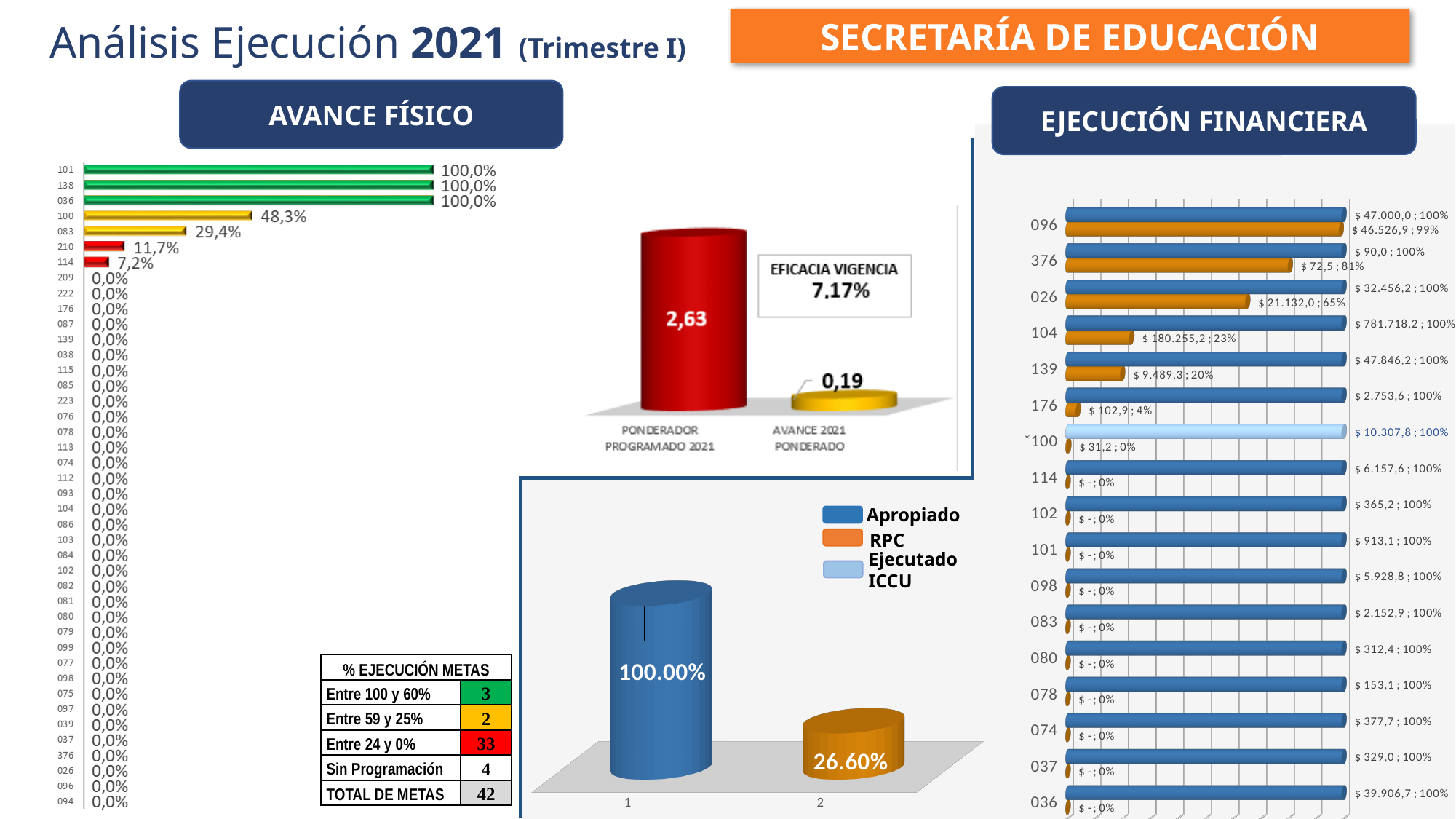
In the Eficacia Vigencia chart in the middle, what is the value for Avance 2021 Ponderado? 0,19 In the Eficacia Vigencia chart in the middle, which category has the highest value? Ponderador Programado 2021 In the Ejecución Financiera chart on the right, how many categories are shown? 17 In the Ejecución Financiera chart on the right, what is the RPC value label for category 376? $ 72,5 ; 81% In the Ejecución Financiera chart on the right, what is the Apropiado value label for category 104? $ 781.718,2 ; 100% In the Avance Físico bar chart on the left, what is the value for category 083? 29,4% In the bottom-middle chart with the blue and orange cylinders, what is the value for category 2? 26.60% In the Eficacia Vigencia chart in the middle, what is the value for Ponderador Programado 2021? 2,63 In the bottom-middle chart with the blue and orange cylinders, how many entries does the legend list? 3 In the Avance Físico bar chart on the left, what is the difference between the values for categories 100 and 083? 18,9% In the Avance Físico bar chart on the left, what is the value for category 100? 48,3% In the Avance Físico bar chart on the left, which has the larger value, category 210 or category 114? 210